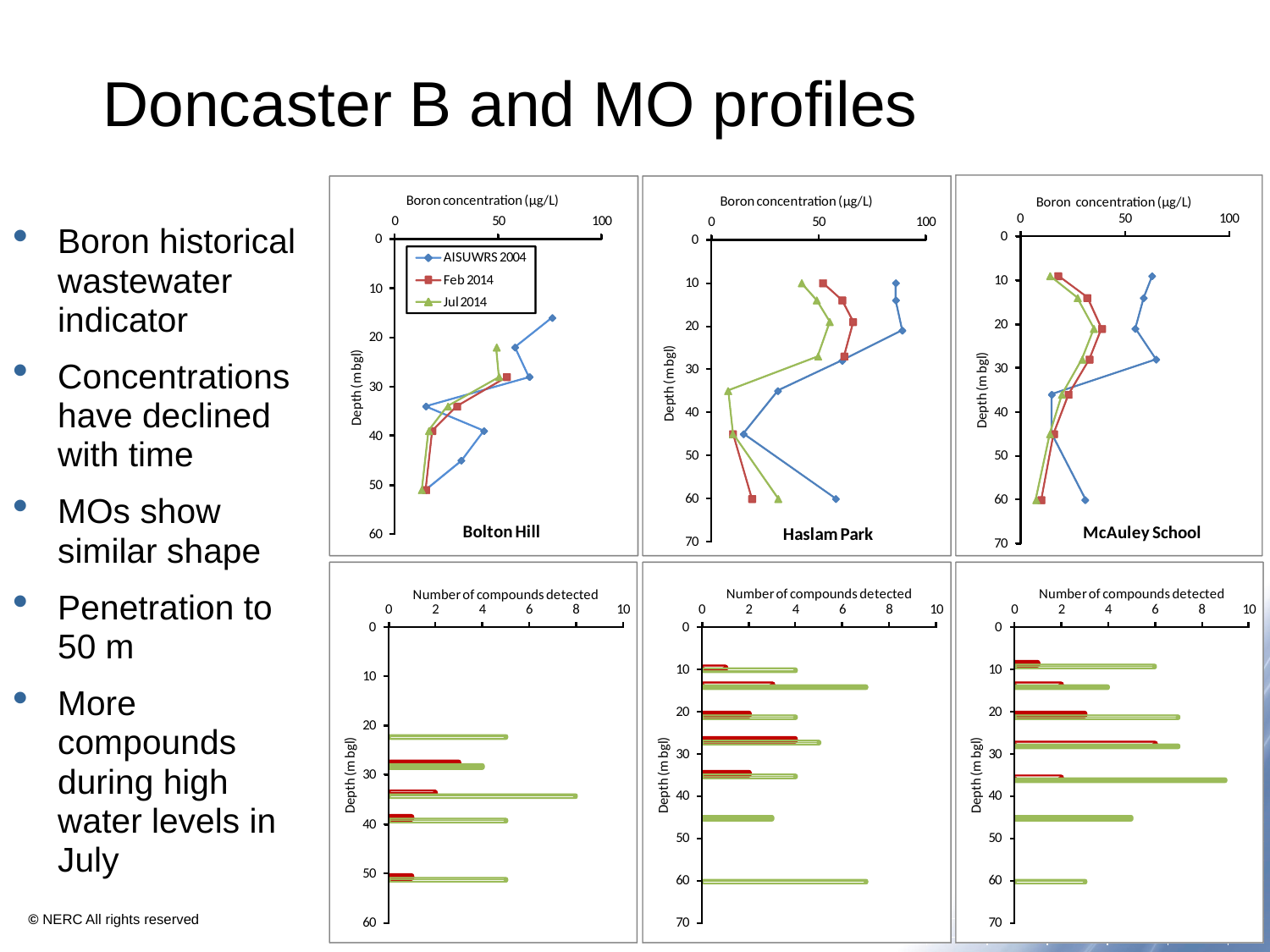
How many series does the legend on the Bolton Hill boron concentration chart list? 3 In the Haslam Park boron concentration chart, at 60 m depth, which series has the larger boron concentration: AISUWRS 2004 or Feb 2014? AISUWRS 2004 What kind of chart is the Bolton Hill boron concentration chart (top left)? line chart In the Haslam Park boron concentration chart, does the AISUWRS 2004 series rise or fall as depth increases from about 21 m to 45 m? fall What are the three series named in the legend of the Bolton Hill boron concentration chart? AISUWRS 2004, Feb 2014, Jul 2014 What is the x-axis title of the three top charts? Boron concentration (µg/L) In the Number of compounds detected chart below McAuley School, is the green bar at about 36 m depth greater or less than 8? greater In the Haslam Park boron concentration chart, is the AISUWRS 2004 value at about 21 m depth greater or less than 50? greater In the Number of compounds detected chart below Bolton Hill, at which depth is the longest green (Jul 2014) bar? 34 m What kind of chart is the Number of compounds detected chart below Bolton Hill (bottom left)? bar chart In the McAuley School boron concentration chart, is the Jul 2014 value at about 9 m depth greater or less than 50? less In the McAuley School boron concentration chart, at about 28 m depth, which series has the larger value: AISUWRS 2004 or Jul 2014? AISUWRS 2004